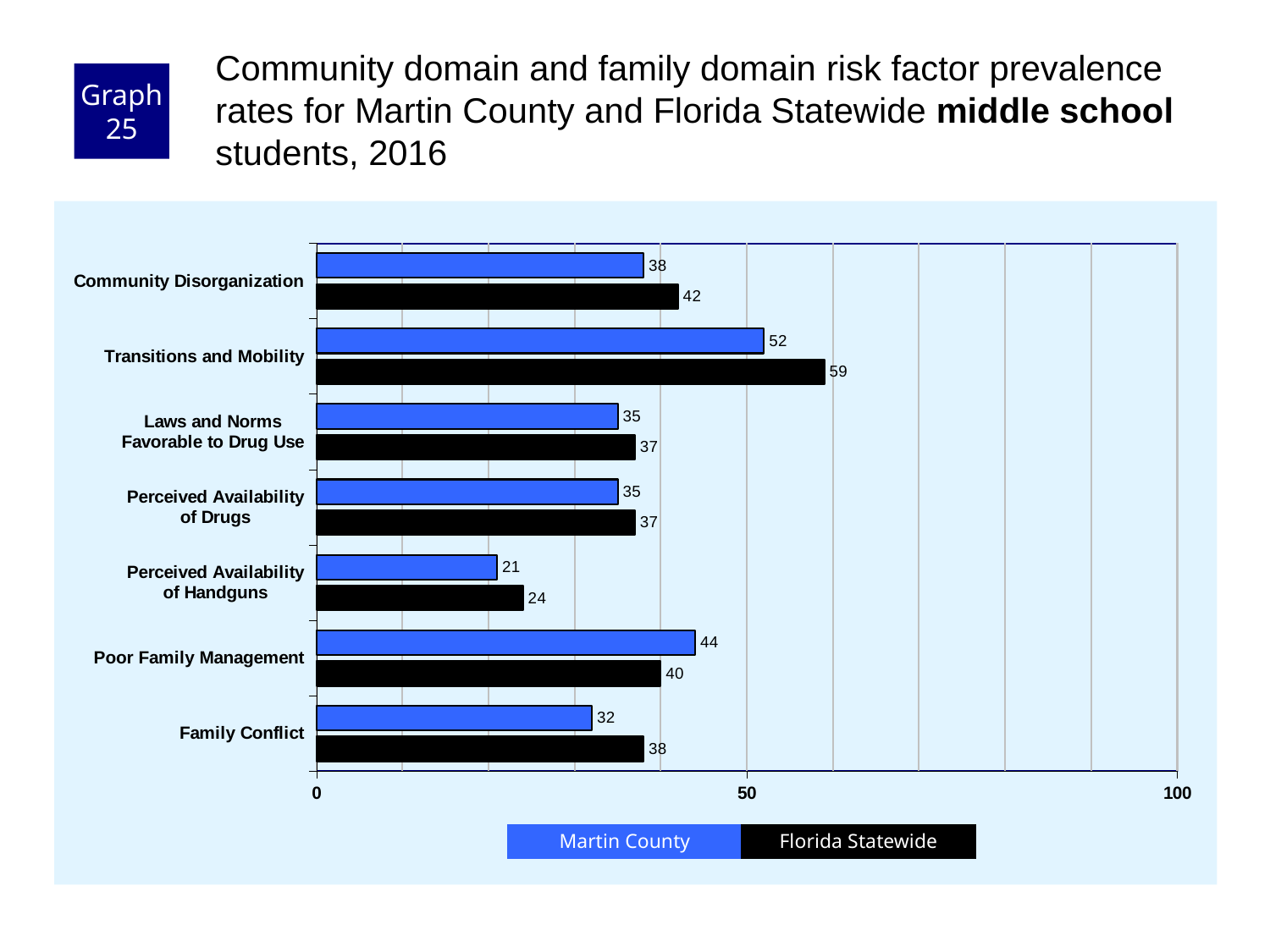
What is the difference between the Florida Statewide and Martin County values for Transitions and Mobility? 7 Is the Florida Statewide value for Transitions and Mobility greater or less than 50? greater How many series does the legend list? 2 Which colour represents Florida Statewide in the chart? black What is the Martin County value for Transitions and Mobility? 52 Which risk factor has the highest Florida Statewide value? Transitions and Mobility For Poor Family Management, which is larger: the Martin County value or the Florida Statewide value? Martin County What kind of chart is shown on the slide? bar chart How many risk factor categories are shown on the chart? 7 What is the Florida Statewide value for Family Conflict? 38 Which risk factor has the lowest Martin County value? Perceived Availability of Handguns What is the Florida Statewide value for Perceived Availability of Handguns? 24